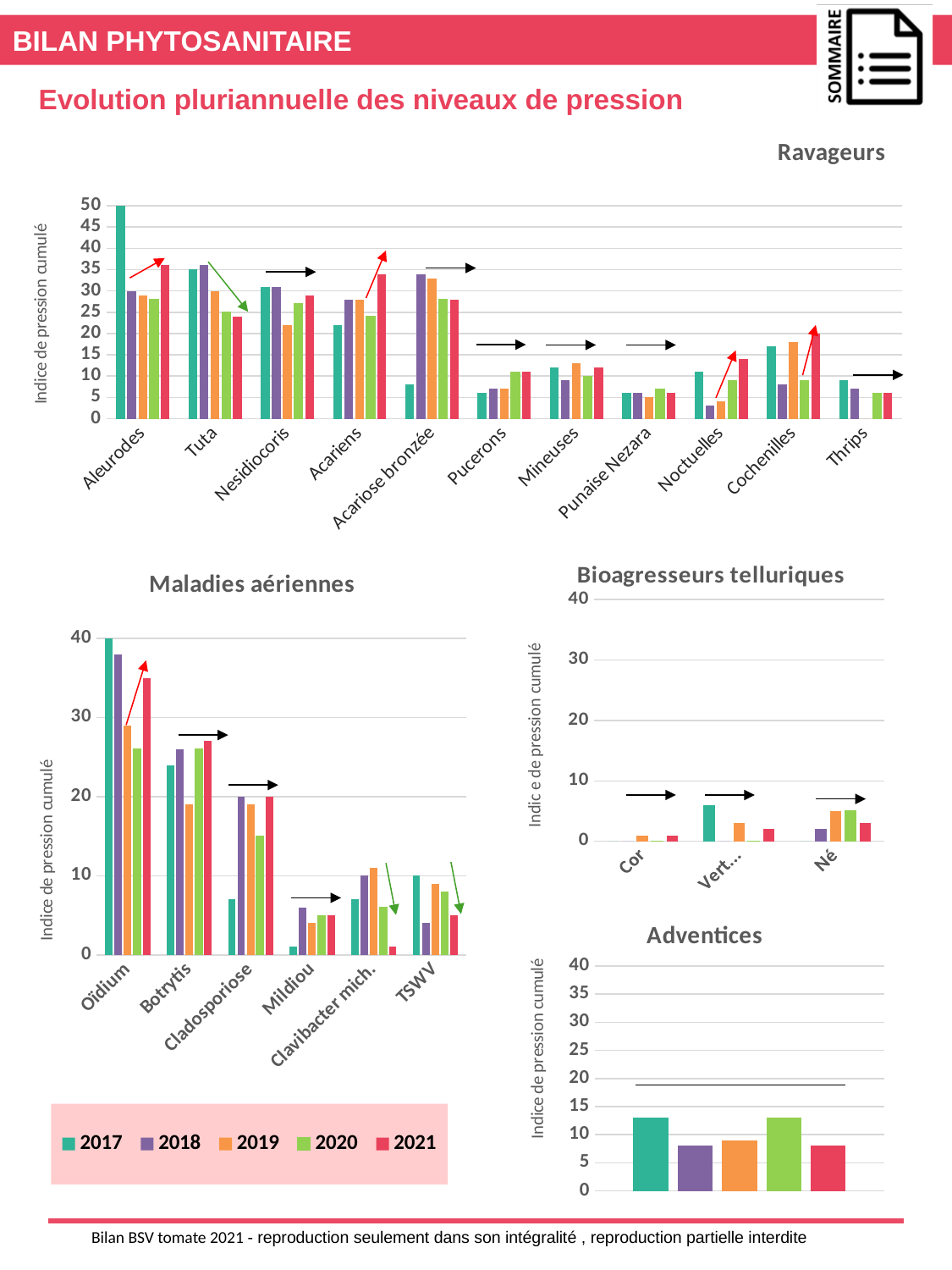
On the 'Maladies aériennes' chart, which is larger: the 2021 value for Oïdium or the 2021 value for Botrytis? Oïdium On the 'Ravageurs' chart, is the 2017 value for Acariose bronzée greater or less than 10? less What kind of chart is the 'Ravageurs' chart? bar chart On the 'Maladies aériennes' chart, what is the 2017 value for Oïdium? 40 How many series does the legend list? 5 On the 'Adventices' chart, is the 2017 bar greater or less than 10? greater How many categories are shown on the 'Maladies aériennes' chart? 6 On the 'Maladies aériennes' chart, which category has the lowest 2017 value? Mildiou On the 'Maladies aériennes' chart, is the 2020 value for Cladosporiose greater or less than 20? less How many categories are shown on the 'Ravageurs' chart? 11 On the 'Ravageurs' chart, which category has the highest 2017 value? Aleurodes